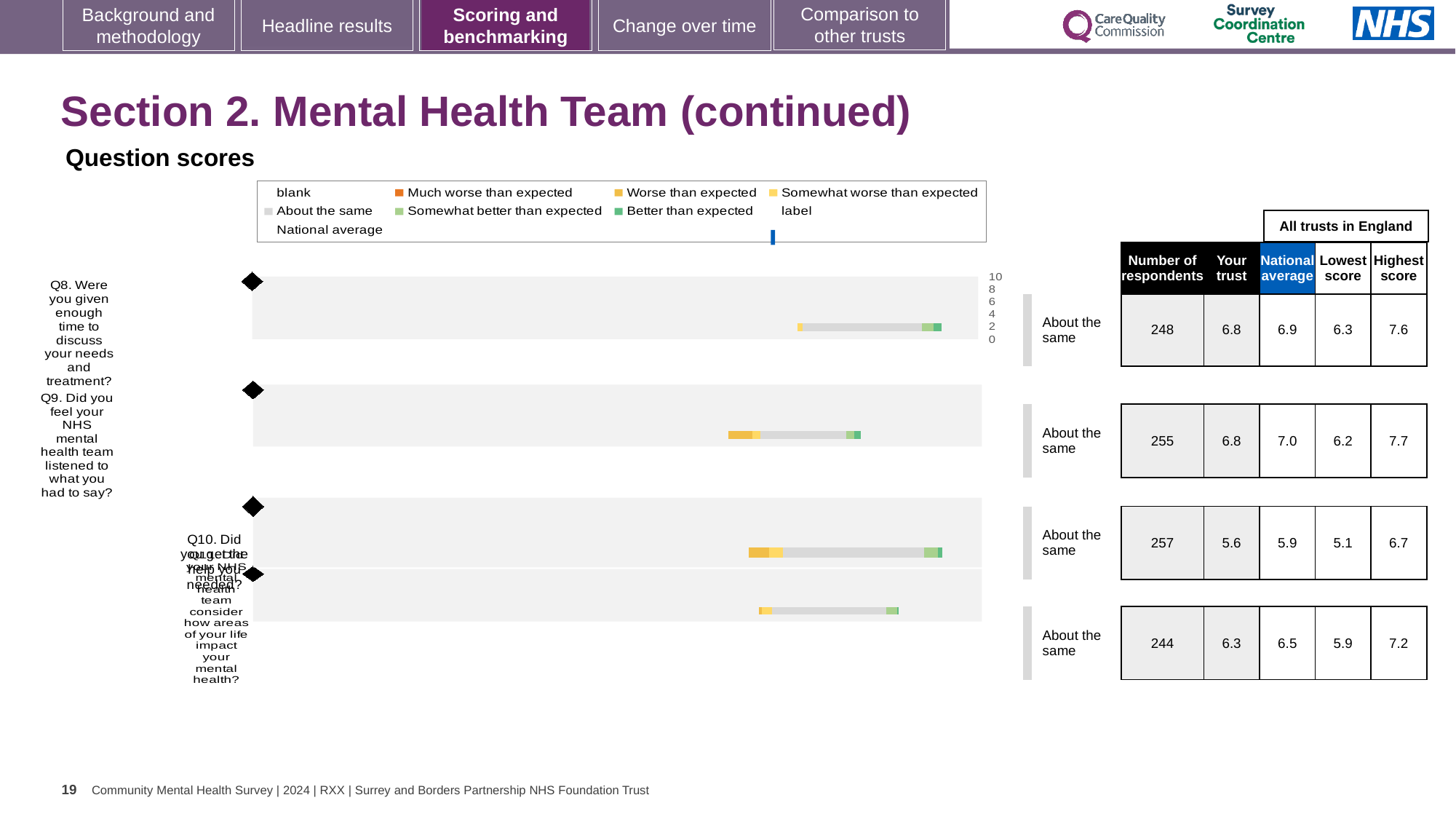
How many questions (bars) are plotted in the question scores chart? 4 Which question has the highest 'Highest score' across all trusts in England? Q9 What is the national average score for Q9 (Did you feel your NHS mental health team listened to what you had to say?)? 7.0 What kind of chart is used to show the question scores on this slide? bar chart What is the 'Your trust' score for Q8 (Were you given enough time to discuss your needs and treatment?)? 6.8 For Q8, what is the difference between the highest score (7.6) and the lowest score (6.3) across all trusts? 1.3 What benchmark category label is shown next to each of the four bars in the chart? About the same For Q8, which is larger: the 'Your trust' score or the national average? National average What is the lowest score across all trusts in England for the fourth question (Q11)? 5.9 Which question has the lowest 'Your trust' score? Q10 How many respondents answered Q10 (Did you get the help you needed?)? 257 How many entries does the legend of the question scores chart list? 9